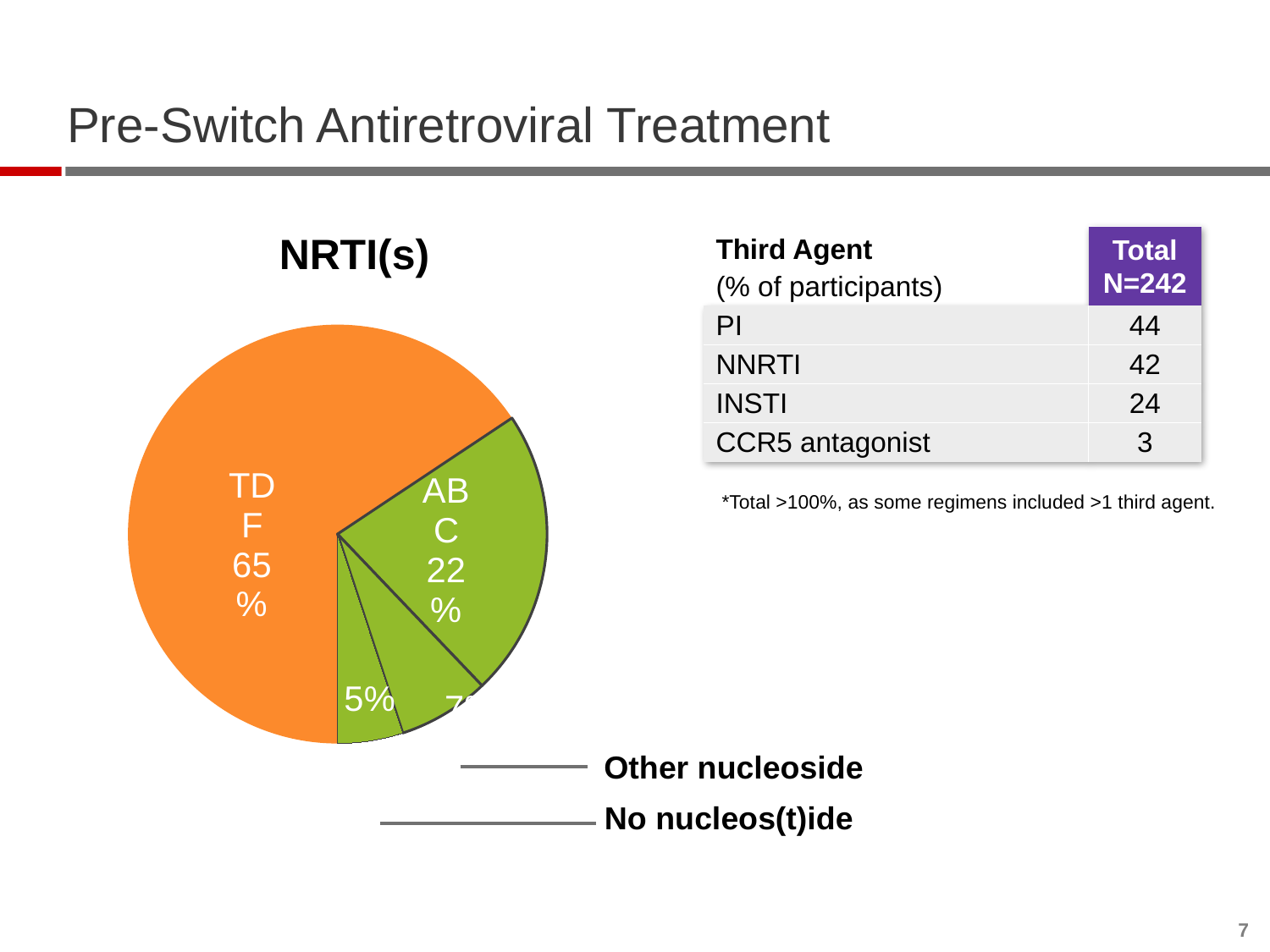
Which is larger in the NRTI(s) pie chart, TDF or ABC? TDF What share of the NRTI(s) pie does the ABC slice represent? 22% Which category has the largest slice in the NRTI(s) pie chart? TDF What is the difference in percentage points between the TDF and ABC slices in the NRTI(s) pie chart? 43 What percentage of the NRTI(s) pie chart is ABC? 22% What colour is the TDF slice in the NRTI(s) pie chart? Orange What is the title of the pie chart on the slide? NRTI(s) How many slices does the NRTI(s) pie chart have? 4 What kind of chart is shown on the slide? Pie chart What percentage of the NRTI(s) pie chart is TDF? 65%